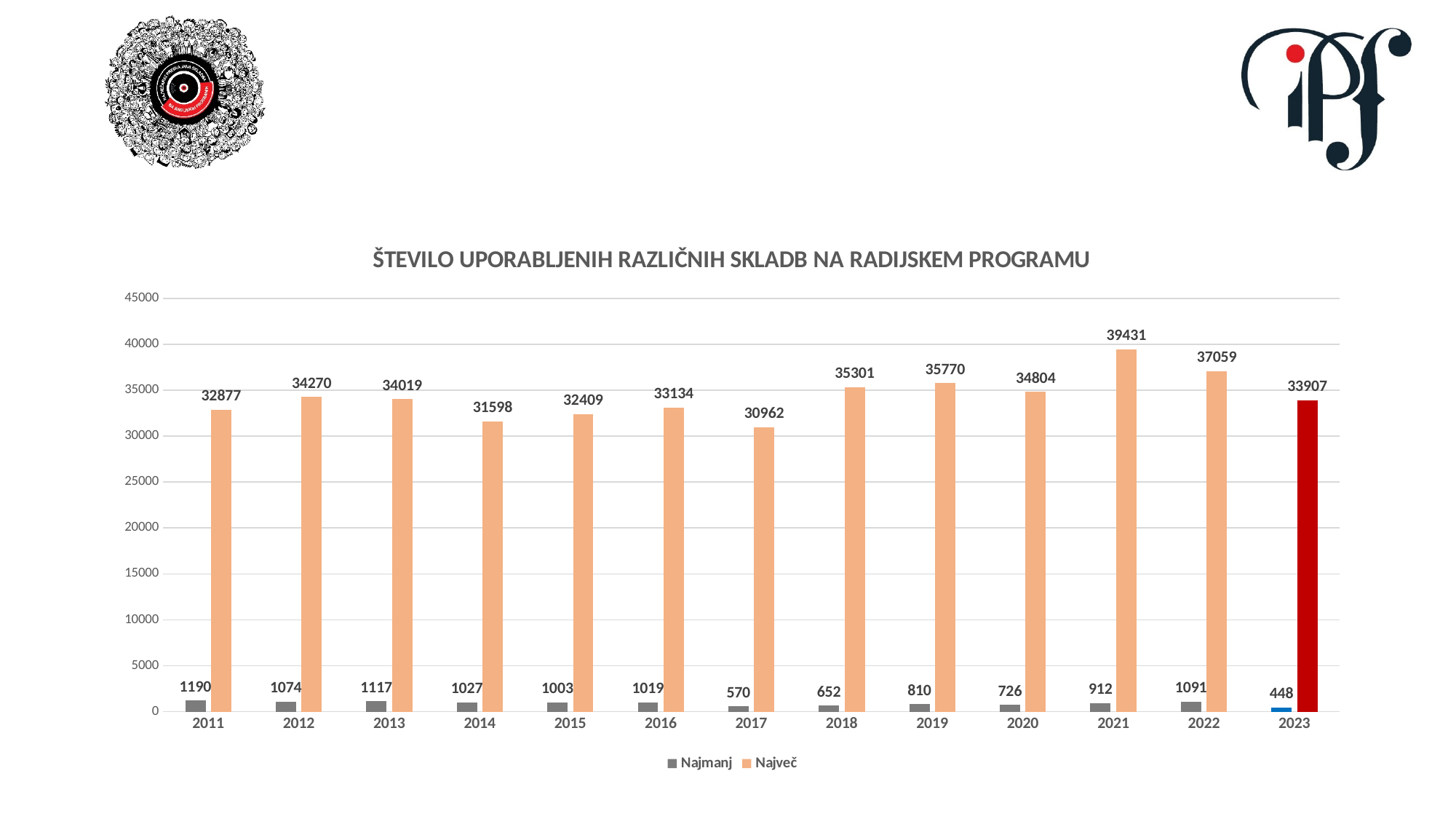
What is the Najmanj value for 2017? 570 Which is larger, the Najmanj value for 2011 or for 2013? 2011 What is the Največ value for 2021? 39431 Which year has the lowest Najmanj value? 2023 What kind of chart is shown on the slide? bar chart How many series does the legend list? 2 What is the difference between the Največ values for 2022 and 2023? 3152 Which year has the lowest Največ value? 2017 How many years are shown on the x axis? 13 What is the Največ value for 2023? 33907 What is the title of the chart? ŠTEVILO UPORABLJENIH RAZLIČNIH SKLADB NA RADIJSKEM PROGRAMU Which year has the highest Največ value? 2021